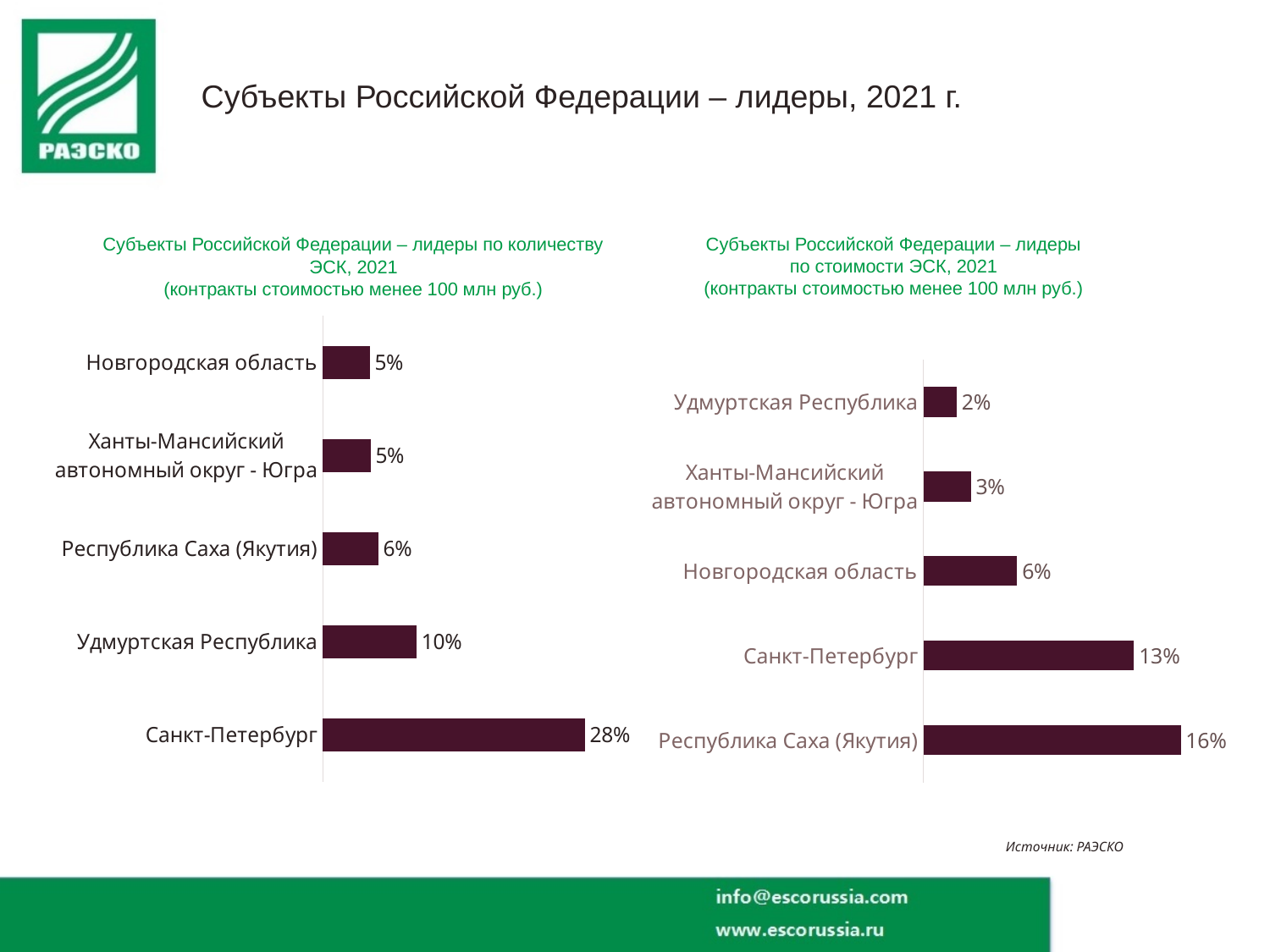
In the right chart (leaders by value of ESC), which region has the lowest value? Удмуртская Республика What type of chart is the right chart (leaders by value of ESC)? Bar chart In the left chart (leaders by number of ESC), what is the value for Удмуртская Республика? 10% In the right chart (leaders by value of ESC), what is the value for Республика Саха (Якутия)? 16% In the right chart (leaders by value of ESC), what is the difference between Республика Саха (Якутия) and Санкт-Петербург? 3% In the right chart (leaders by value of ESC), what is the value for Удмуртская Республика? 2% In the left chart (leaders by number of ESC), what is the difference between Санкт-Петербург and Удмуртская Республика? 18% In the left chart (leaders by number of ESC), what is the value for Санкт-Петербург? 28% In the right chart (leaders by value of ESC), which is larger: Новгородская область or Ханты-Мансийский автономный округ - Югра? Новгородская область In the right chart (leaders by value of ESC), which region has the highest value? Республика Саха (Якутия) How many regions are shown in the left chart (leaders by number of ESC)? 5 In the left chart (leaders by number of ESC), which region has the highest value? Санкт-Петербург